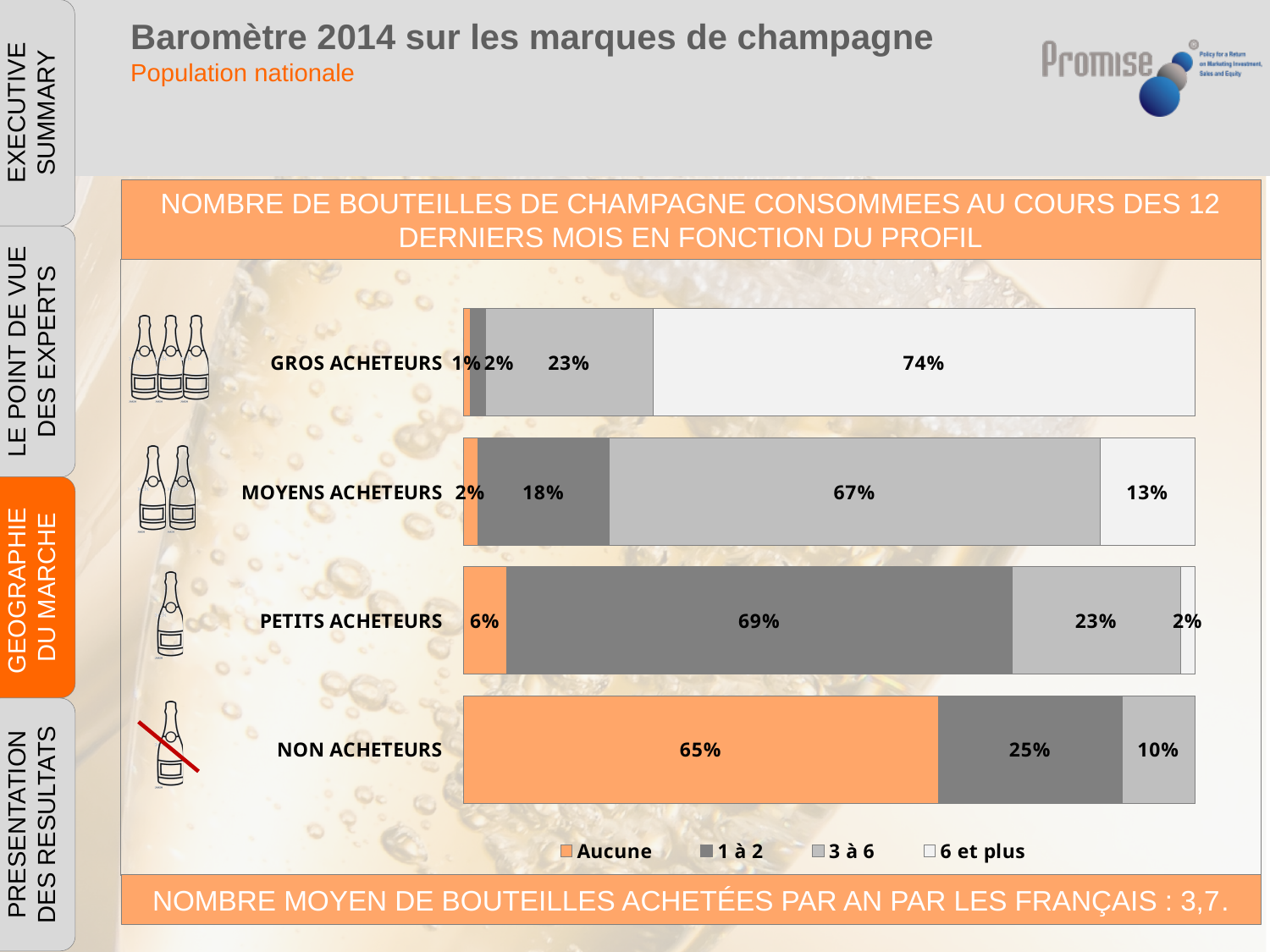
What is the value for '3 à 6' for MOYENS ACHETEURS? 67% How many series does the legend list? 4 Which profile has the highest value for 'Aucune'? NON ACHETEURS How many buyer profiles (categories) are shown in the chart? 4 What is the value for 'Aucune' for NON ACHETEURS? 65% What is the value for '6 et plus' for GROS ACHETEURS? 74% Which is larger: the '1 à 2' value for NON ACHETEURS or for MOYENS ACHETEURS? NON ACHETEURS What is the difference between the '3 à 6' values for MOYENS ACHETEURS and GROS ACHETEURS? 44% What kind of chart is shown on the slide? Stacked bar chart What is the value for '1 à 2' for PETITS ACHETEURS? 69% Which legend entry is shown in orange? Aucune